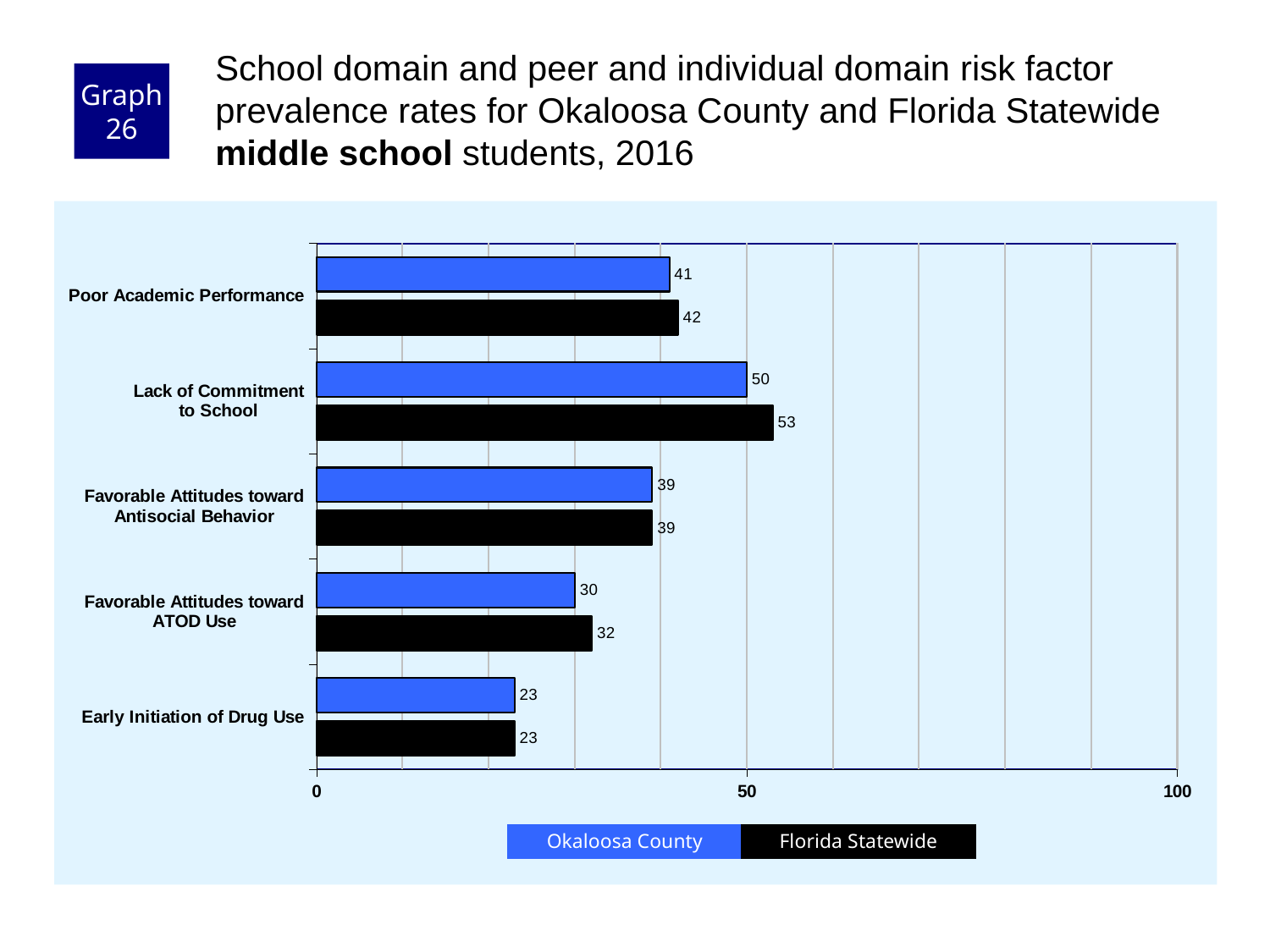
How many risk factor categories are shown on the chart? 5 What is the difference between the Florida Statewide and Okaloosa County values for Lack of Commitment to School? 3 What kind of chart is shown on the slide? bar chart Which risk factor has the lowest Okaloosa County value? Early Initiation of Drug Use How many series does the legend list? 2 Which risk factor has the highest Florida Statewide value? Lack of Commitment to School What is the Okaloosa County value for Lack of Commitment to School? 50 What is the Okaloosa County value for Early Initiation of Drug Use? 23 For Poor Academic Performance, which is larger: the Okaloosa County value or the Florida Statewide value? Florida Statewide Is the Florida Statewide value for Lack of Commitment to School greater or less than 50? greater Which colour represents Okaloosa County in the chart? blue What is the Florida Statewide value for Favorable Attitudes toward ATOD Use? 32